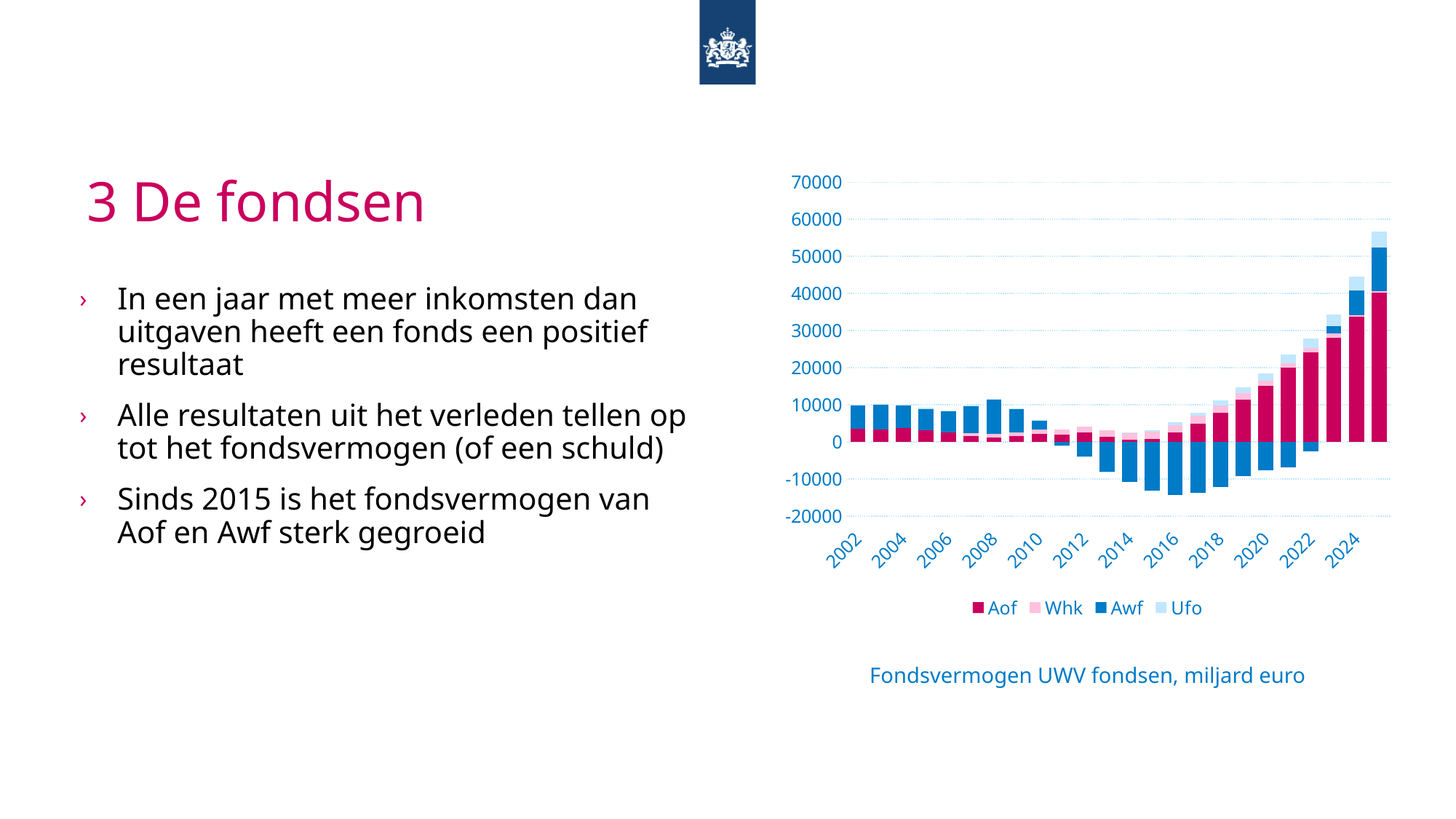
Which is larger, the Aof value for 2022 or the Aof value for 2012? 2022 What kind of chart is shown on the slide? stacked bar chart Which series are listed in the chart legend? Aof, Whk, Awf, Ufo Is the Aof value for 2020 greater or less than 10000? greater Which is larger, the Aof value for 2024 or the Aof value for 2020? 2024 How many series does the chart legend list? 4 Is the Awf value for 2002 greater or less than 0? greater What is the caption/title of the chart? Fondsvermogen UWV fondsen, miljard euro Do the Aof values rise or fall from 2016 to 2024? rise Is the Aof value for 2022 greater or less than 20000? greater